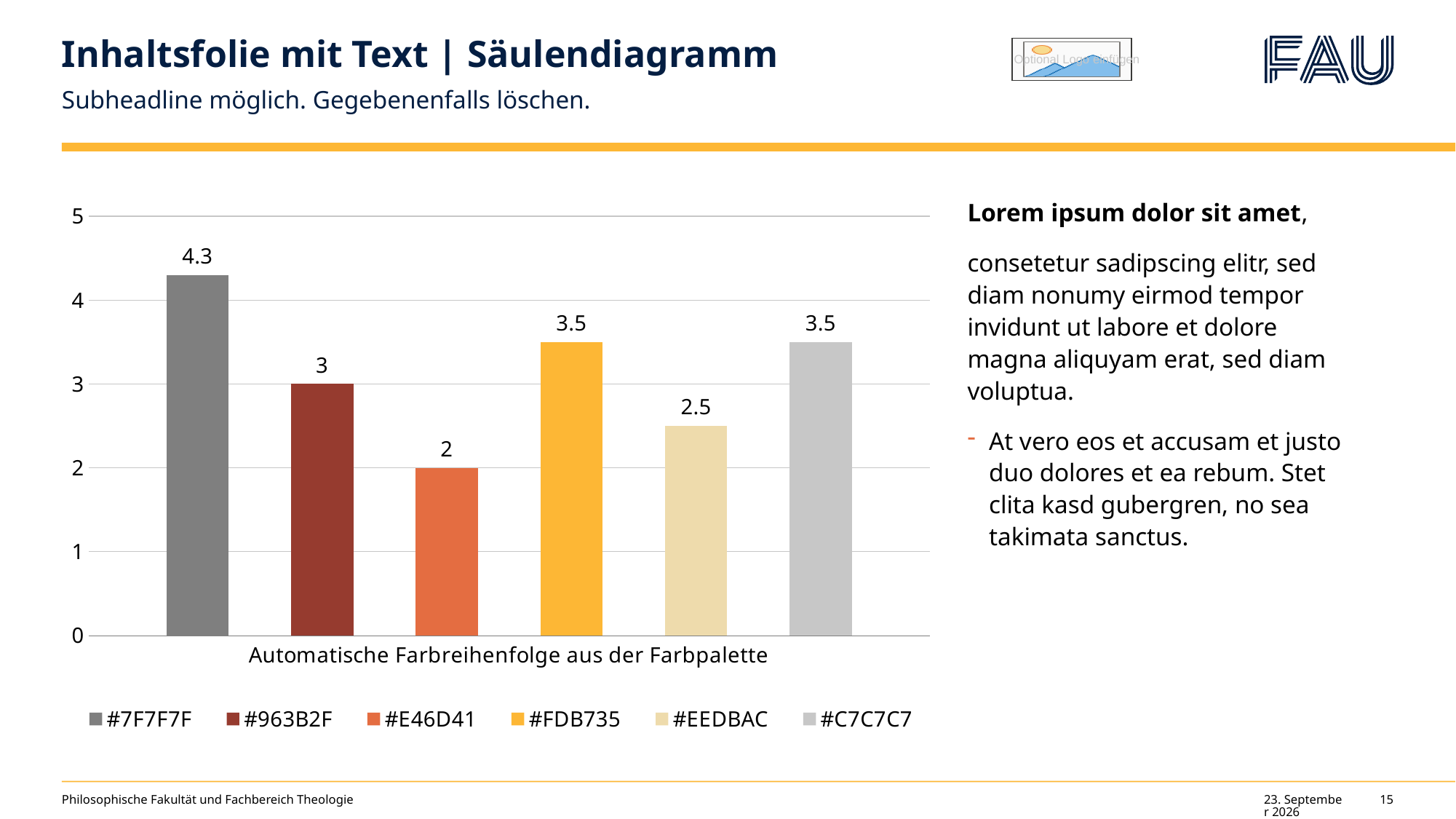
What is the difference between the values for #7F7F7F and #963B2F? 1.3 What is the value for the #E46D41 series? 2 How many series does the legend list? 6 Is the value for #FDB735 greater or less than 3? greater How many bars are plotted in the chart? 6 What kind of chart is shown on the slide? bar chart Which series has the highest value? #7F7F7F What is the value for the #7F7F7F series? 4.3 Which series has the lowest value? #E46D41 What is the value for the #EEDBAC series? 2.5 Which is larger, the value for #963B2F or the value for #EEDBAC? #963B2F What is the category label shown below the bars on the x axis? Automatische Farbreihenfolge aus der Farbpalette